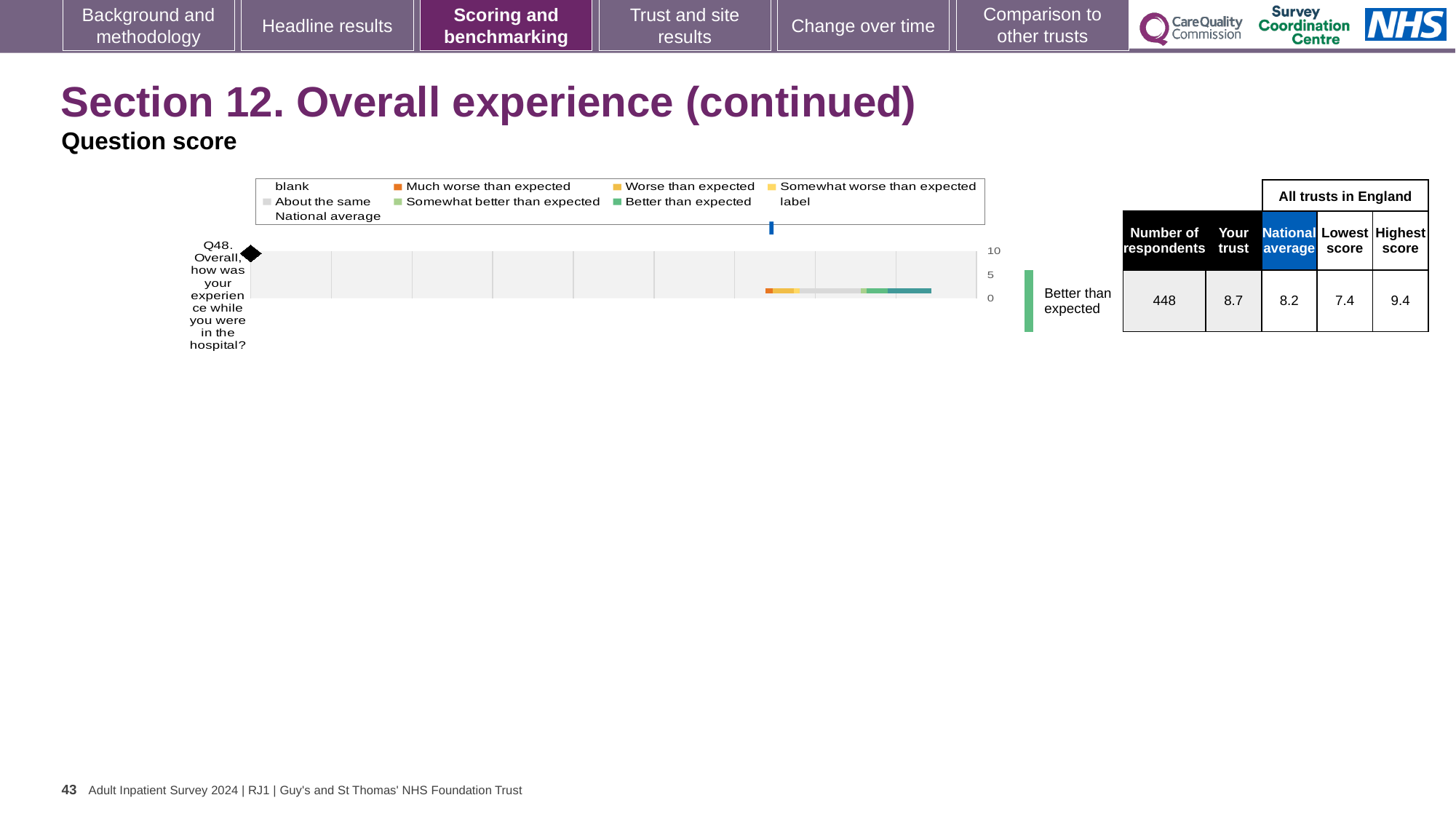
What benchmark category is shown next to the bar for Q48? Better than expected What is the highest score among all trusts in England for Q48? 9.4 Which question is plotted on the chart? Q48. Overall, how was your experience while you were in the hospital? How many entries does the chart legend list? 9 What is the lowest score among all trusts in England for Q48? 7.4 What is the 'Your trust' score for Q48? 8.7 What kind of chart is shown on the slide? bar chart Which is larger for Q48, the 'Your trust' score or the national average? Your trust What is the number of respondents for Q48? 448 How many questions (categories) are plotted on the chart? 1 What is the difference between the 'Your trust' score and the national average for Q48? 0.5 What is the national average score for Q48? 8.2